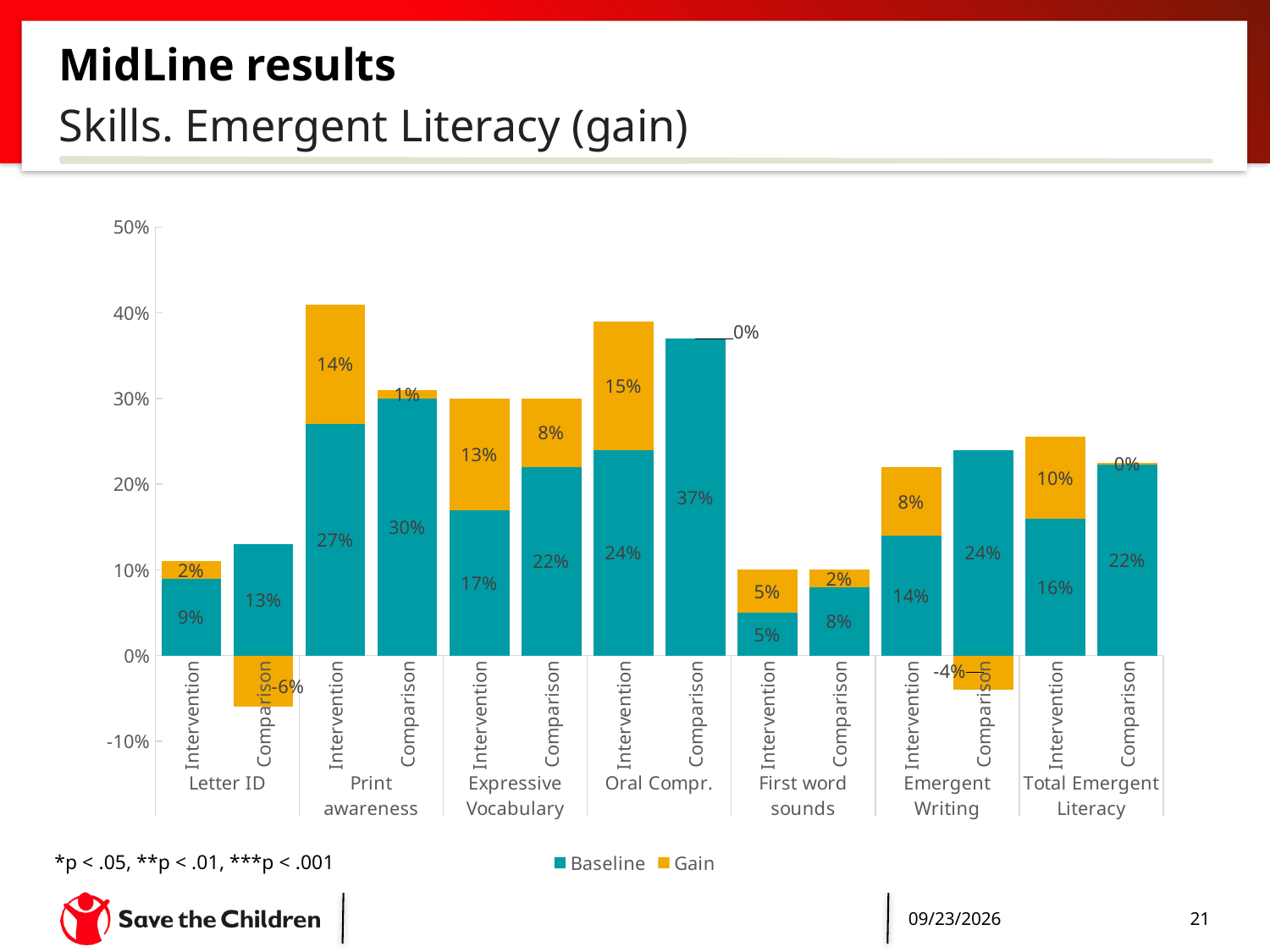
What is the Gain value for the Oral Compr. Intervention group? 15% What is the Baseline value for the Emergent Writing Comparison group? 24% How many bars are plotted in the chart? 14 What is the total height (Baseline plus Gain) of the Print awareness Intervention bar? 41% Which is larger, the Baseline for the Expressive Vocabulary Intervention group or the Baseline for the Expressive Vocabulary Comparison group? Expressive Vocabulary Comparison What is the Gain value for the Letter ID Comparison group? -6% What is the difference between the Gain for the Total Emergent Literacy Intervention group and the Gain for the Total Emergent Literacy Comparison group? 10% How many series does the legend list? 2 Which bar has the highest Gain value? Oral Compr. Intervention Which bar has the lowest Gain value? Letter ID Comparison What type of chart is shown on the slide? Stacked bar chart What is the Baseline value for the Print awareness Intervention group? 27%